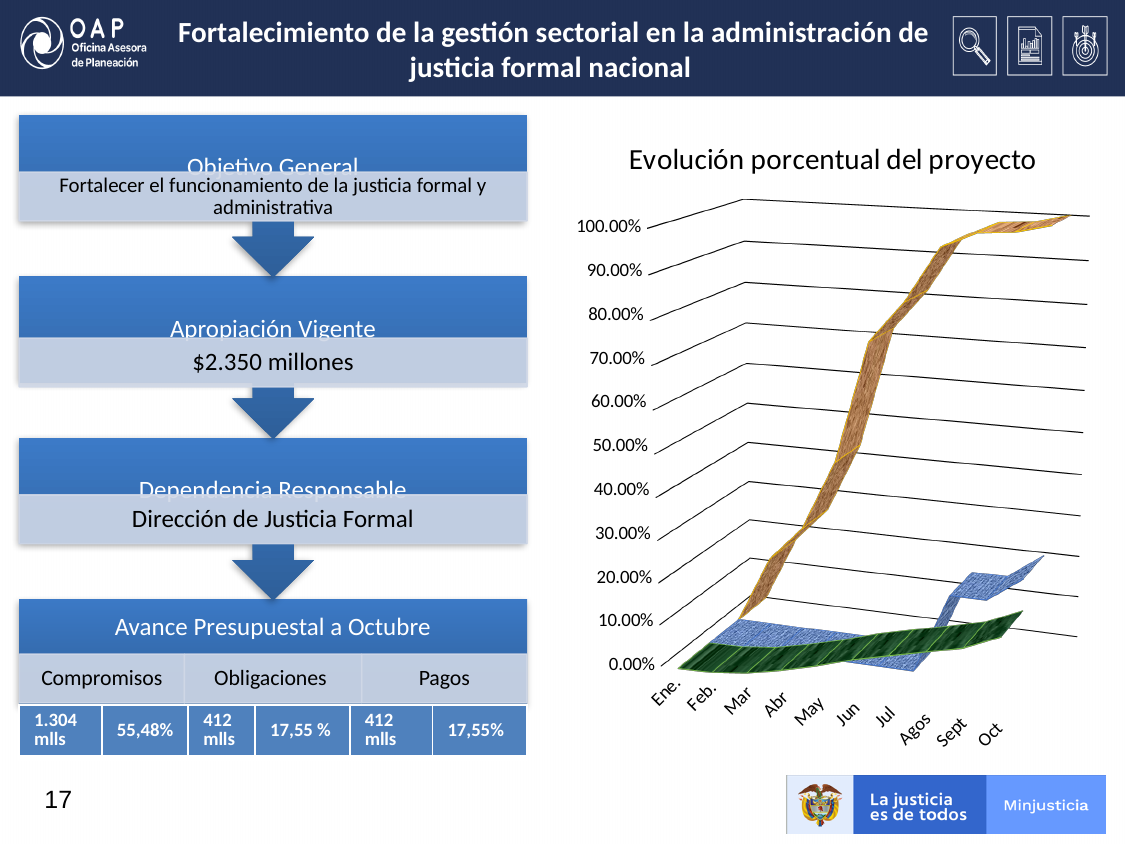
Which month is the last category on the x axis of the chart? Oct What kind of chart is shown on the slide? 3D line chart Does the brown (topmost) series in the chart rise or fall from Ene. to Oct? rise What is the highest value shown on the vertical axis of the chart? 100.00% What is the title of the chart on the slide? Evolución porcentual del proyecto How many categories (months) are shown on the x axis of the chart? 10